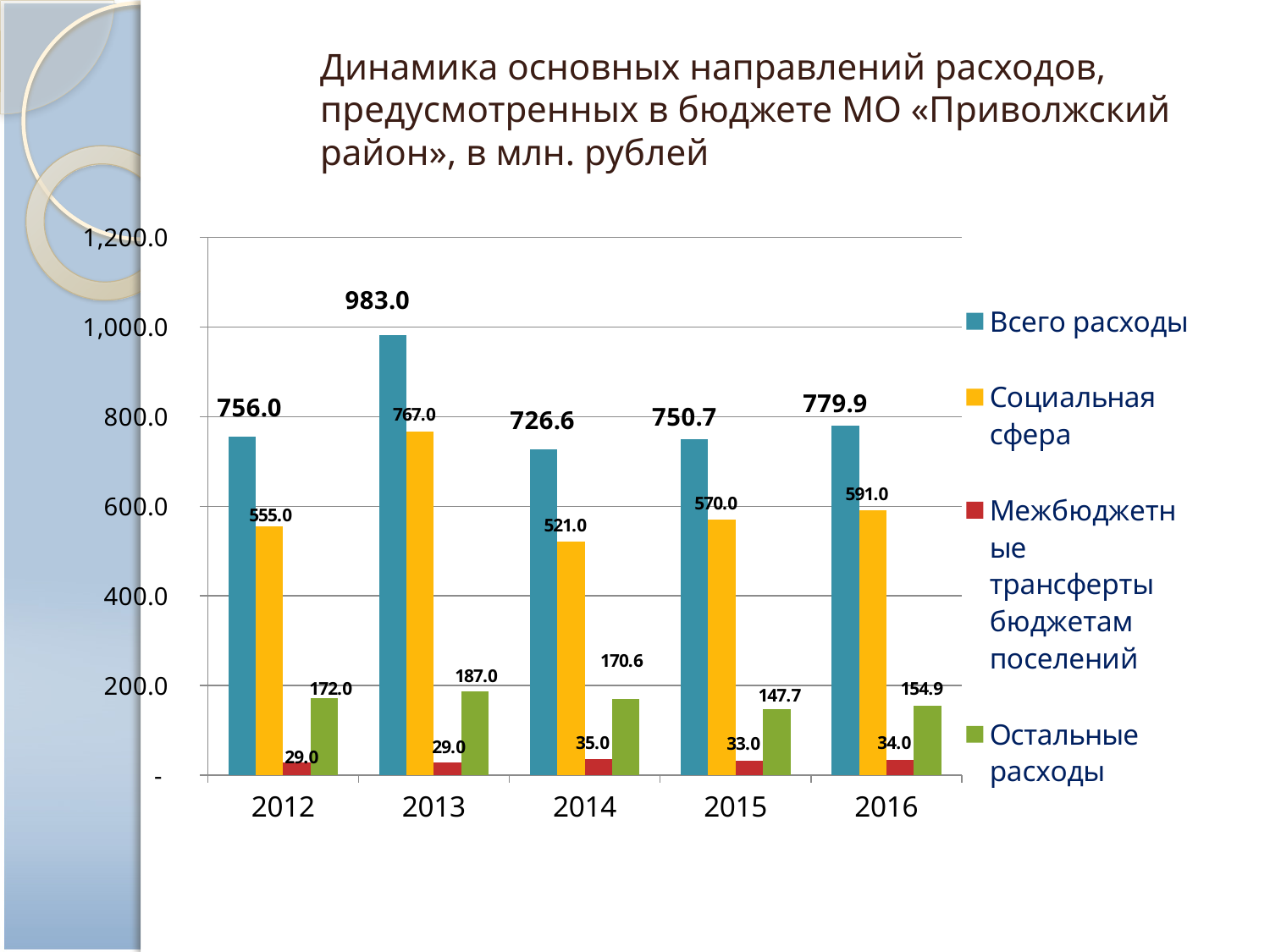
In which year is Социальная сфера lowest? 2014 What kind of chart is shown on the slide? bar chart What is the value of Всего расходы for 2013? 983.0 How many years are shown on the x axis? 5 What is the value of Социальная сфера for 2016? 591.0 Which is larger: Остальные расходы in 2013 or in 2016? 2013 What is the difference between Всего расходы in 2013 and in 2012? 227.0 How many series does the legend list? 4 What is the value of Остальные расходы for 2015? 147.7 What is the value of Межбюджетные трансферты бюджетам поселений for 2014? 35.0 In which year is Всего расходы highest? 2013 Which colour represents Социальная сфера in the legend? yellow